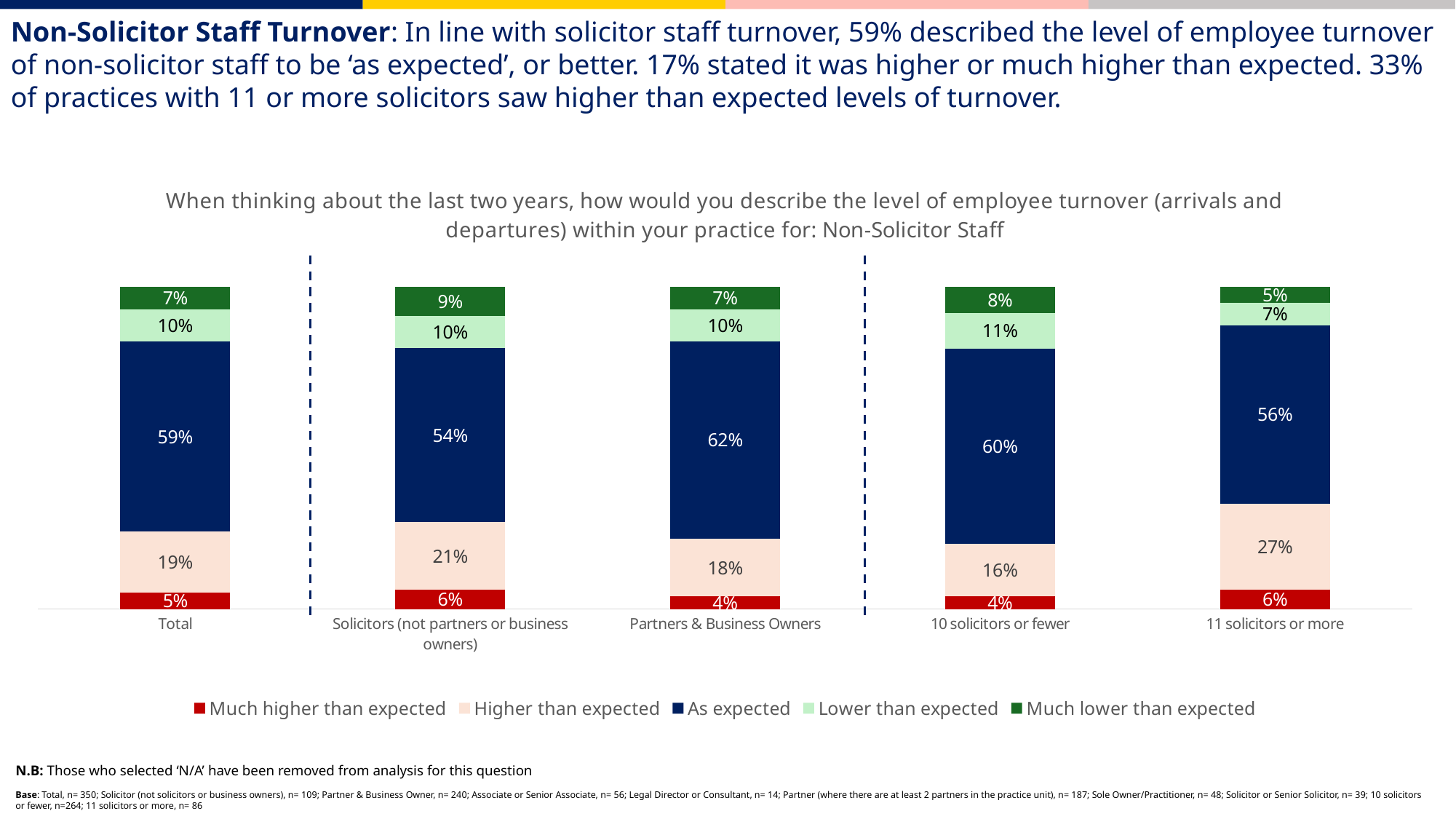
Which category has the highest 'As expected' share? Partners & Business Owners How many percentage points higher is the 'Higher than expected' value for 11 solicitors or more than for 10 solicitors or fewer? 11 percentage points How many categories are shown along the x axis of the chart? 5 Which has a larger 'Much higher than expected' share: Solicitors (not partners or business owners) or Partners & Business Owners? Solicitors (not partners or business owners) What percentage of Partners & Business Owners described non-solicitor staff turnover as 'As expected'? 62% What is the 'Lower than expected' value for practices with 10 solicitors or fewer? 11% Which category has the lowest 'Much lower than expected' share? 11 solicitors or more Which category has the highest 'Higher than expected' share? 11 solicitors or more What is the sum of the segments in the 'Total' bar? 100% How many series does the chart's legend list? 5 What kind of chart is shown on the slide? Stacked bar chart What is the 'Higher than expected' value for practices with 11 solicitors or more? 27%